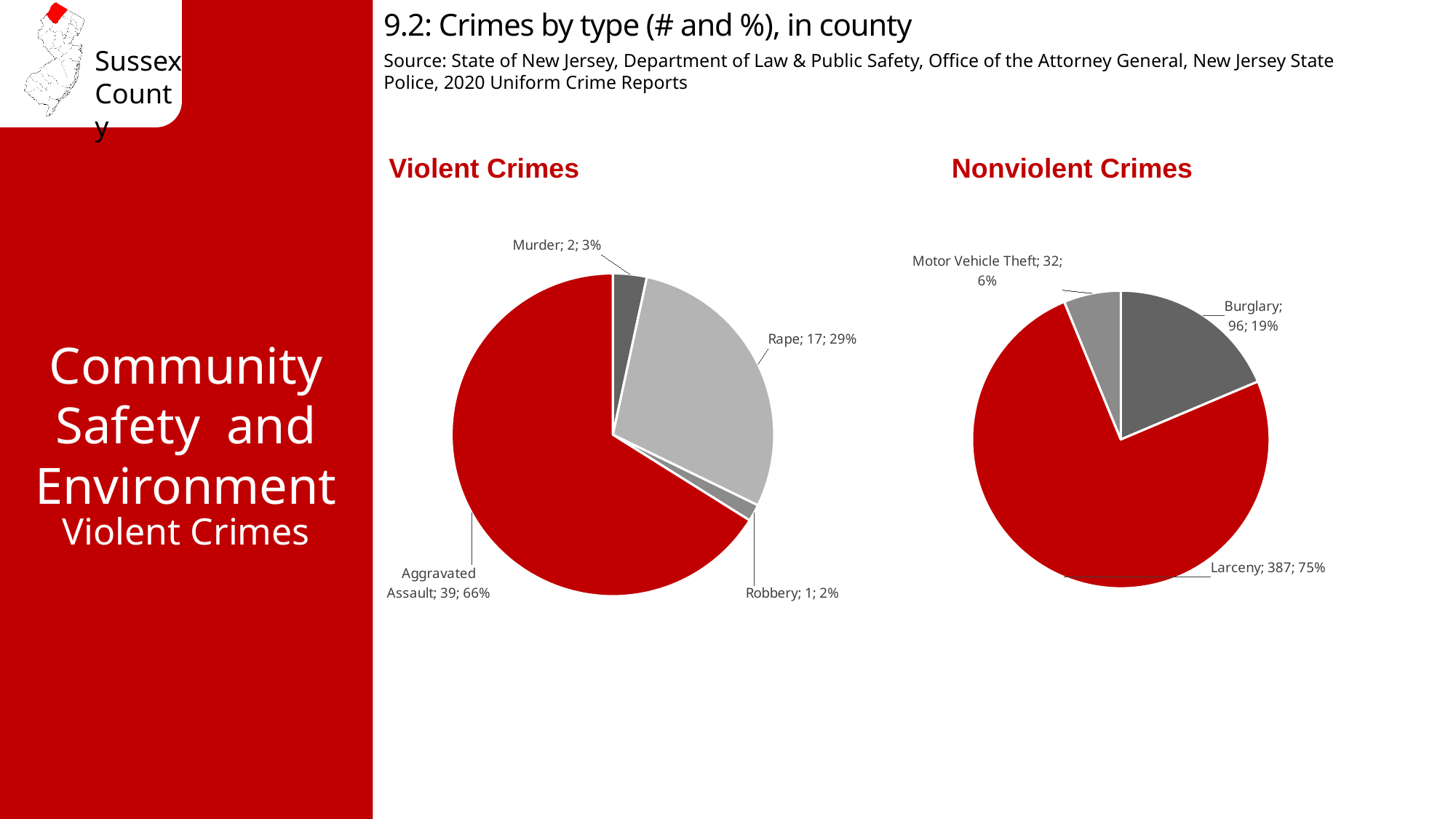
In the Nonviolent Crimes pie chart, which category has the smallest slice? Motor Vehicle Theft In the Violent Crimes pie chart, what is the difference between the number of rapes and the number of murders? 15 In the Nonviolent Crimes pie chart, what share of the pie does Burglary represent? 19% In the Violent Crimes pie chart, what share of the pie does Rape represent? 29% In the Violent Crimes pie chart, which category has the smallest slice? Robbery In the Nonviolent Crimes pie chart, what is the difference between the number of burglaries and the number of motor vehicle thefts? 64 In the Violent Crimes pie chart, how many aggravated assaults are shown? 39 In the Violent Crimes pie chart, how many categories are shown? 4 In the Violent Crimes pie chart, which category has the largest slice? Aggravated Assault What type of chart is used for the Nonviolent Crimes chart? Pie chart In the Nonviolent Crimes pie chart, which is larger, Burglary or Motor Vehicle Theft? Burglary In the Nonviolent Crimes pie chart, how many larcenies are shown? 387